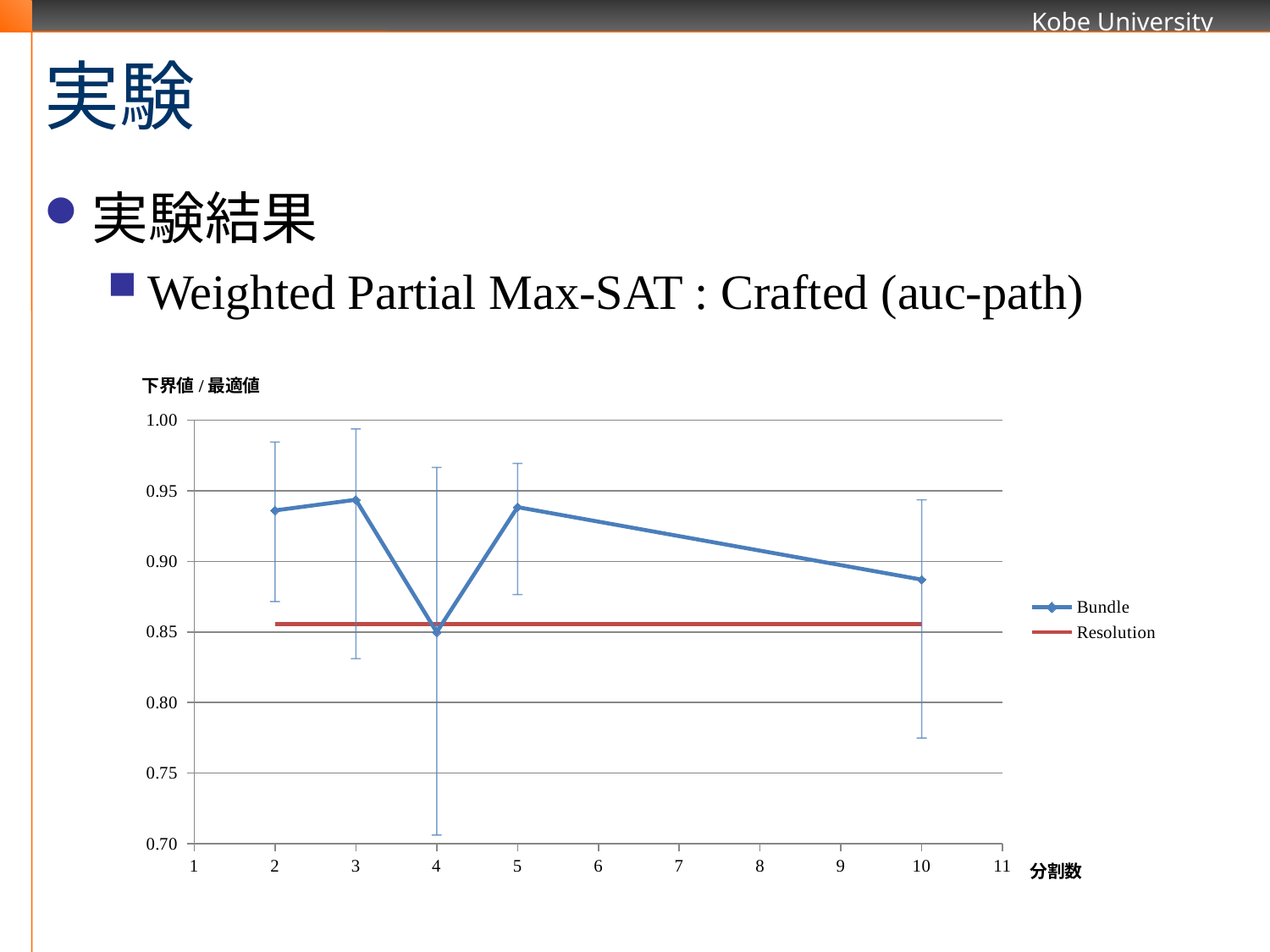
What are the two series named in the legend? Bundle, Resolution What kind of chart is shown on the slide? line chart How many data points are plotted for the Bundle series? 5 What is the label of the x axis? 分割数 Which is larger, the Bundle value at 分割数 5 or at 分割数 10? 分割数 5 Is the Bundle value at 分割数 2 greater or less than 0.90? greater At which 分割数 value is the Bundle series lowest? 4 Does the Bundle series rise or fall from 分割数 5 to 分割数 10? fall Is the Bundle value at 分割数 4 greater or less than 0.90? less Is the Resolution line greater or less than 0.90? less How many series does the legend list? 2